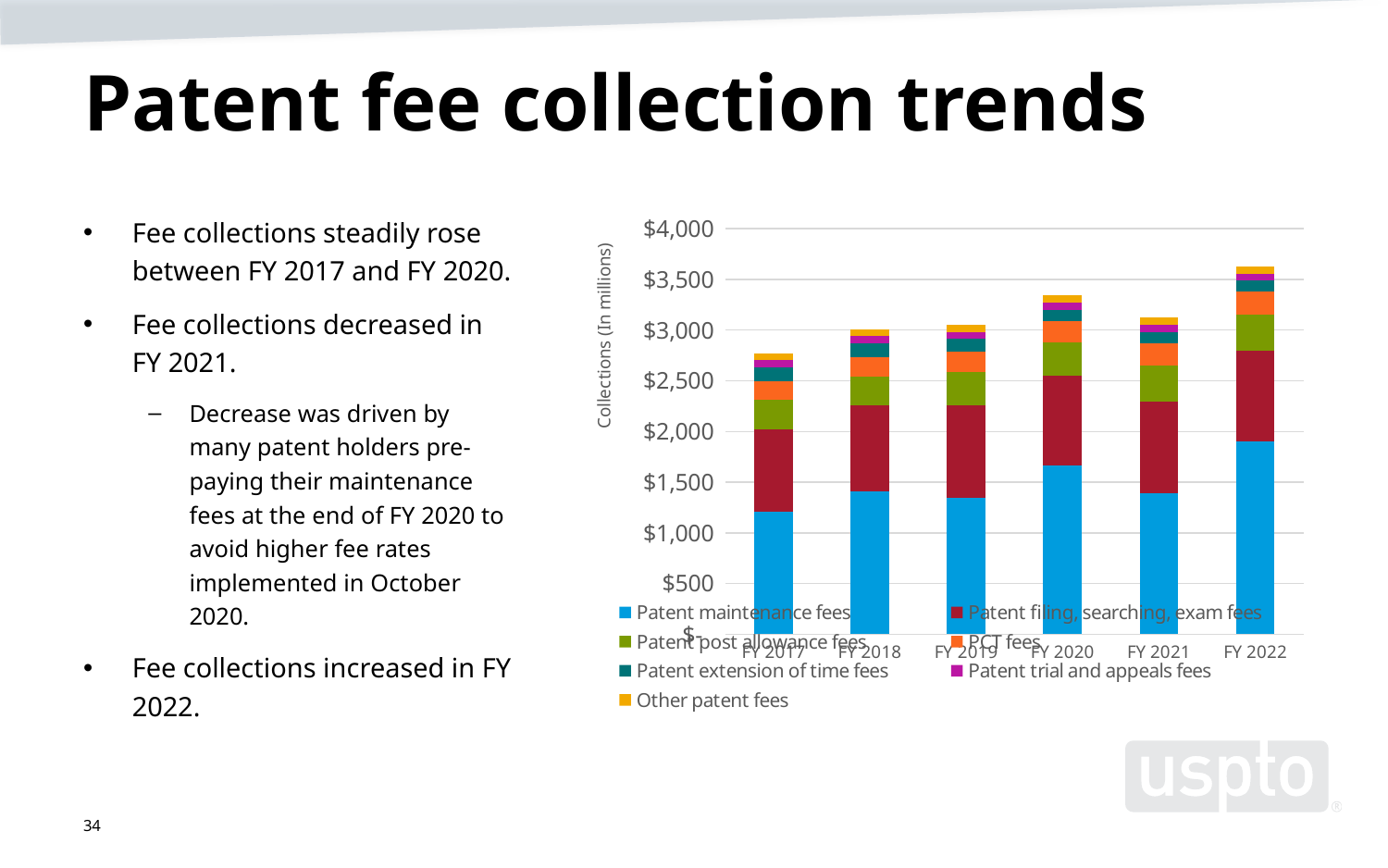
Which fiscal year has the highest total fee collections in the chart? FY 2022 Is the total fee collection for FY 2017 greater or less than $3,000? less Which is larger, the total fee collection for FY 2020 or for FY 2021? FY 2020 How many series does the chart's legend list? 7 What kind of chart is shown on the slide? Stacked bar chart How many fiscal years are shown on the x axis of the chart? 6 Is the total fee collection for FY 2022 greater or less than $3,500? greater Is the value for Patent maintenance fees in FY 2022 greater or less than $1,500? greater Which fiscal year has the lowest total fee collections in the chart? FY 2017 What is the label on the chart's vertical axis? Collections (In millions) Do total fee collections rise or fall from FY 2017 to FY 2020? rise Which fiscal year has the largest Patent maintenance fees segment? FY 2022